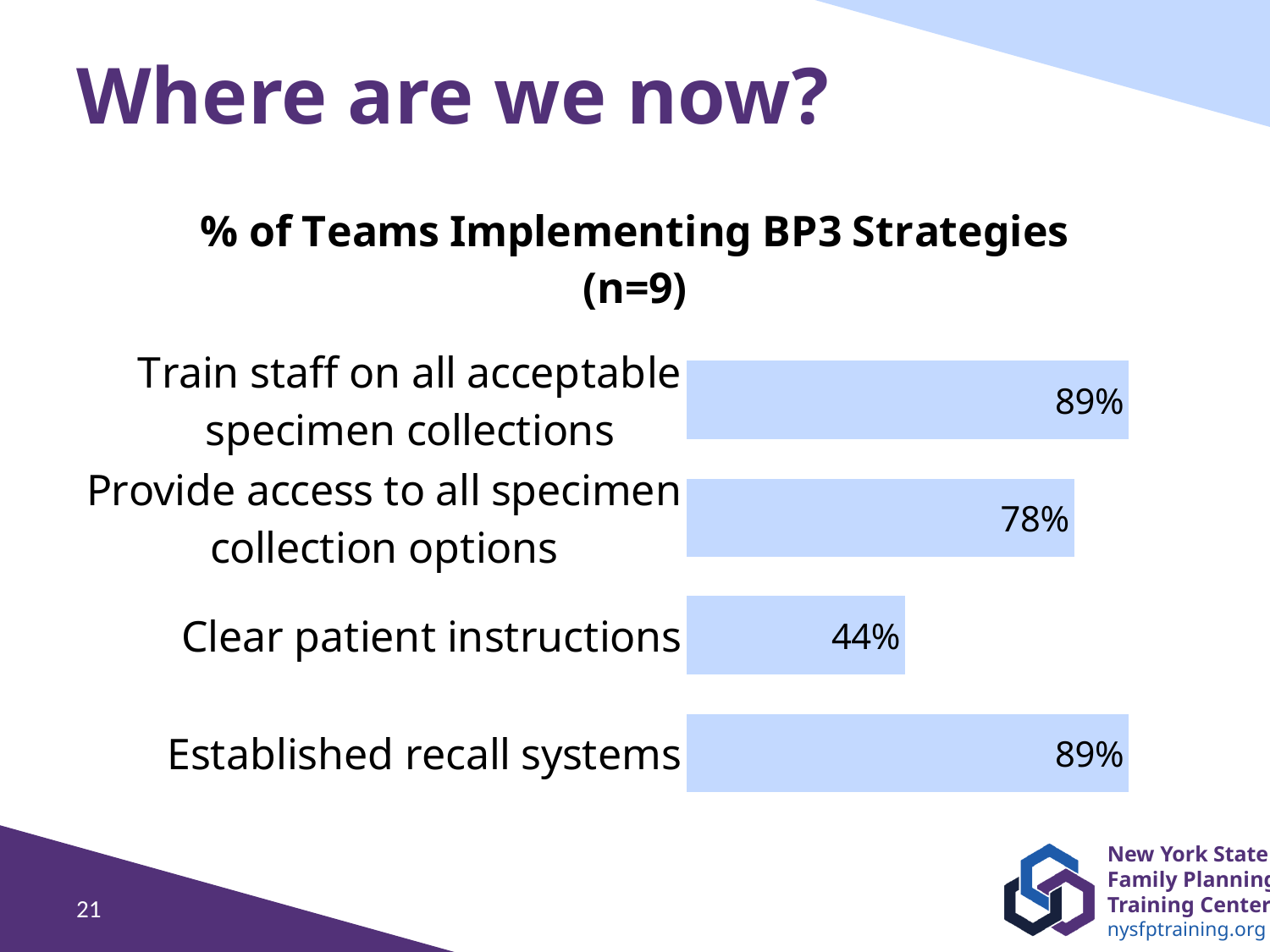
What percentage of teams have implemented 'Train staff on all acceptable specimen collections'? 89% What percentage of teams have implemented 'Clear patient instructions'? 44% What type of chart is shown on the slide? Bar chart What is the difference in percentage points between 'Train staff on all acceptable specimen collections' and 'Provide access to all specimen collection options'? 11 How many strategies are shown in the chart? 4 Which has a higher percentage: 'Established recall systems' or 'Clear patient instructions'? Established recall systems What percentage of teams have implemented 'Provide access to all specimen collection options'? 78% Which strategy has the lowest percentage of teams implementing it? Clear patient instructions What is the title of the chart? % of Teams Implementing BP3 Strategies (n=9) What is the difference in percentage points between 'Provide access to all specimen collection options' and 'Clear patient instructions'? 34 What percentage of teams have implemented 'Established recall systems'? 89% Which has a higher percentage: 'Provide access to all specimen collection options' or 'Clear patient instructions'? Provide access to all specimen collection options